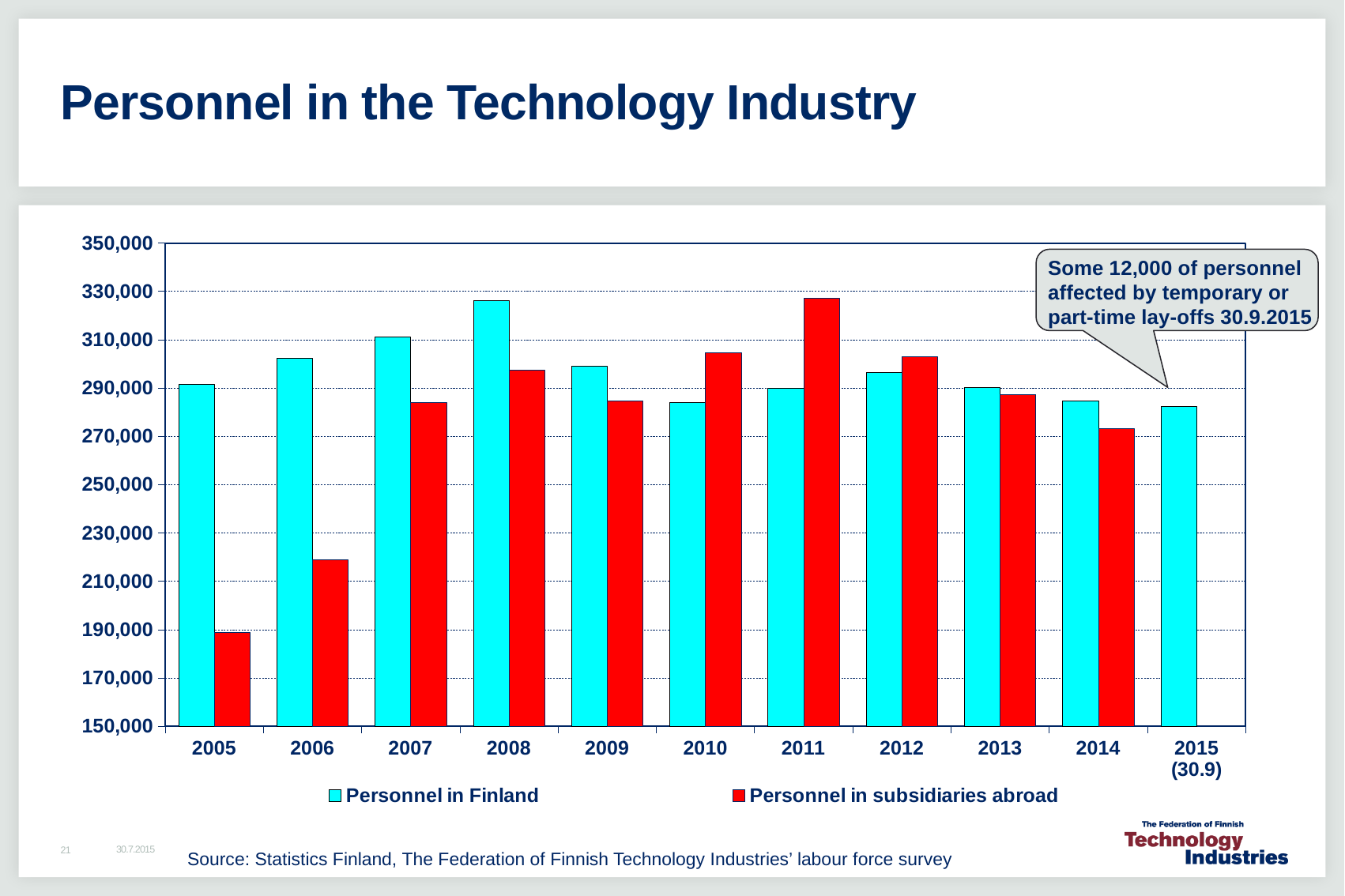
What kind of chart is shown on the slide? Bar chart Is the value for Personnel in subsidiaries abroad in 2006 greater or less than 230,000? less How many series does the legend list? 2 In which year is Personnel in Finland highest? 2008 In which year is Personnel in subsidiaries abroad highest? 2011 How many years are shown on the x axis? 11 In 2005, which is larger: Personnel in Finland or Personnel in subsidiaries abroad? Personnel in Finland In which year is Personnel in subsidiaries abroad lowest? 2005 Is the value for Personnel in subsidiaries abroad in 2014 greater or less than 290,000? less Does Personnel in subsidiaries abroad rise or fall from 2005 to 2011? rise In 2011, which is larger: Personnel in Finland or Personnel in subsidiaries abroad? Personnel in subsidiaries abroad Is the value for Personnel in Finland in 2008 greater or less than 310,000? greater